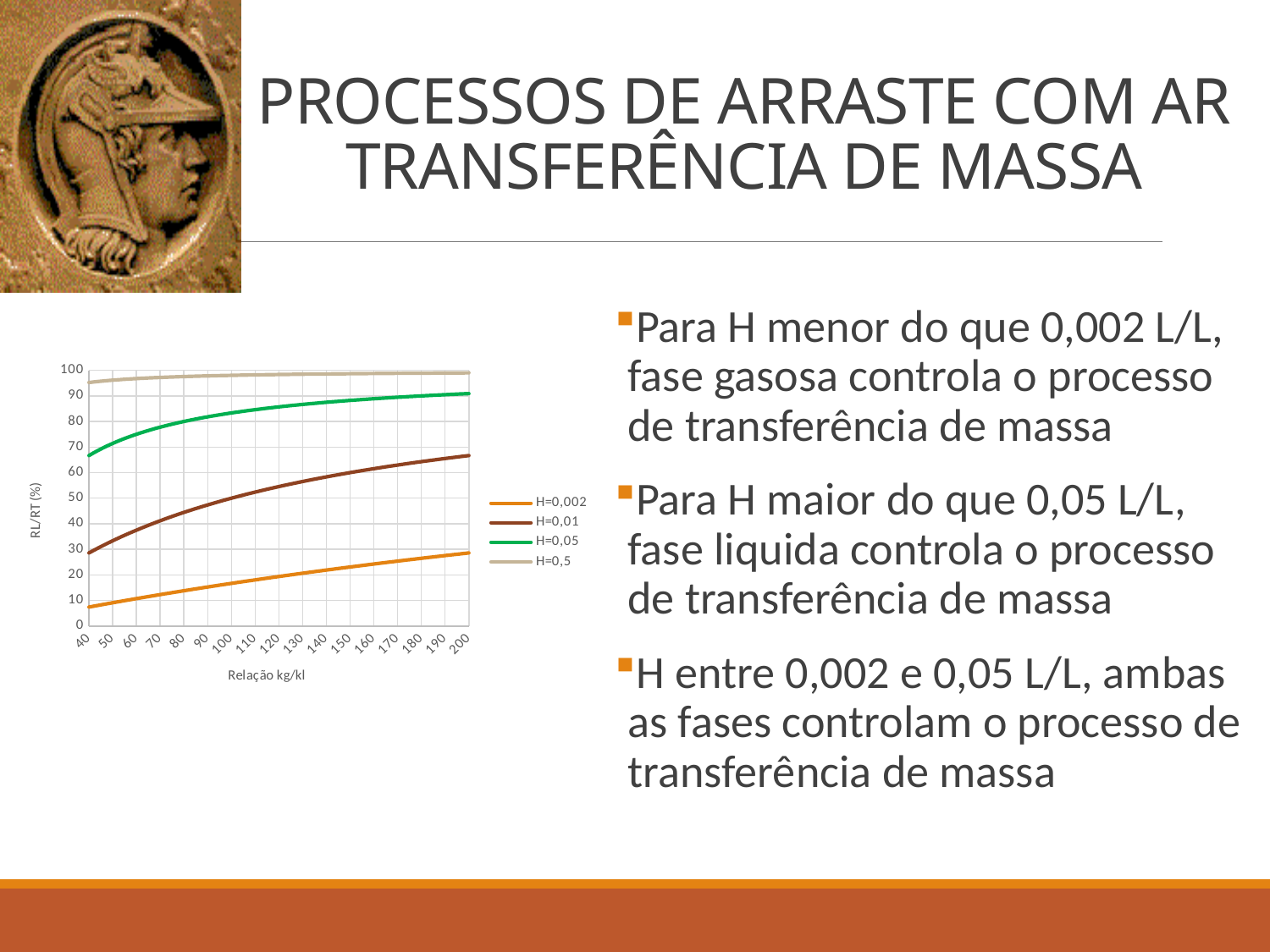
Which series has the lowest RL/RT (%) values across the chart? H=0,002 At Relação 200, which series has the larger RL/RT (%) value: H=0,05 or H=0,01? H=0,05 Is the RL/RT (%) value for H=0,5 at Relação 40 greater or less than 90? greater Is the RL/RT (%) value for H=0,002 at Relação 200 greater or less than 40? less What kind of chart is shown on the slide? line chart What is the label of the chart's x axis? Relação kg/kl Is the RL/RT (%) value for H=0,01 at Relação 40 greater or less than 40? less Does the RL/RT (%) value for the H=0,002 series rise or fall as Relação kg/kl increases from 40 to 200? rise How many series does the chart legend list? 4 Which series has the highest RL/RT (%) values across the chart? H=0,5